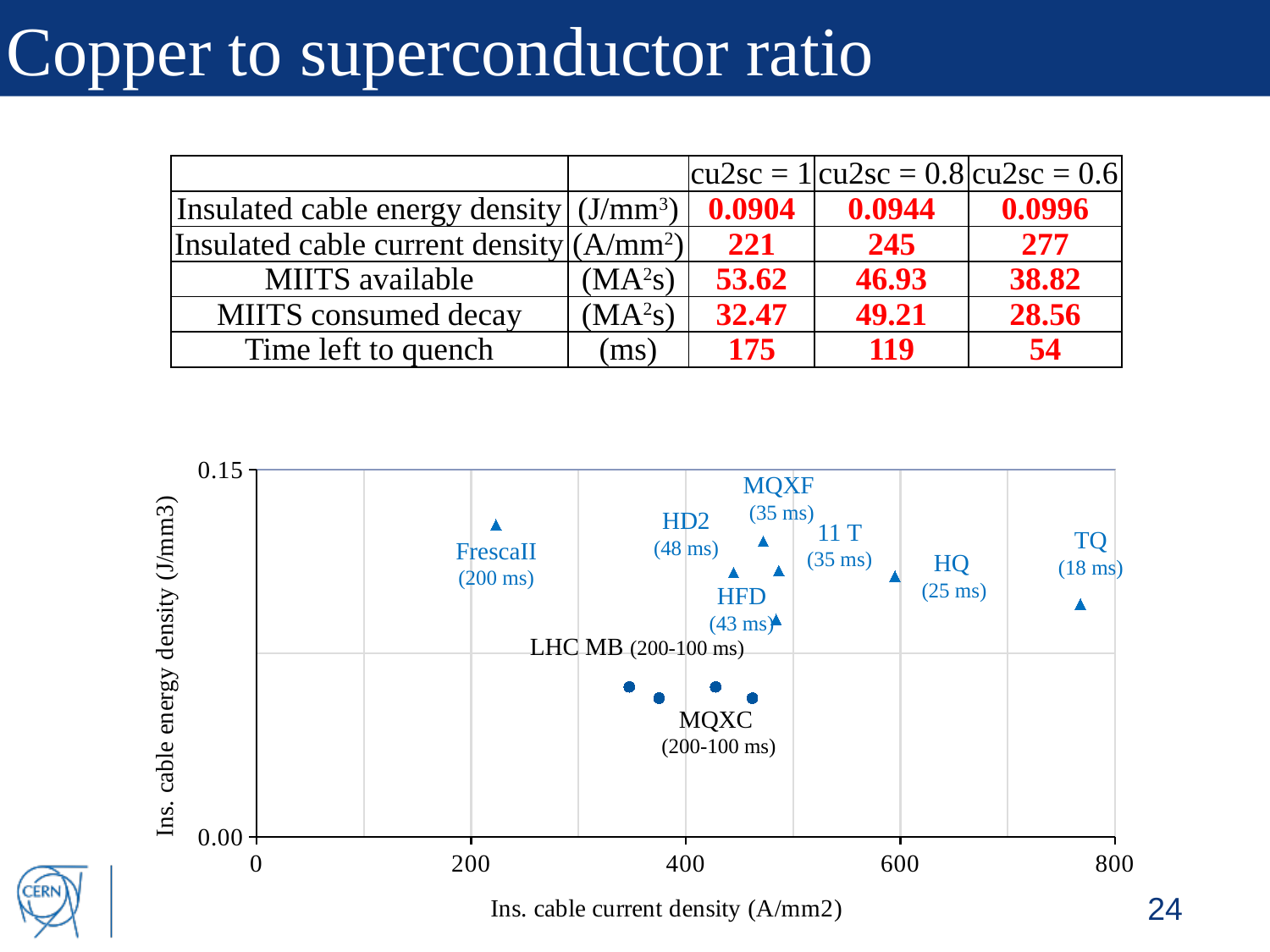
Which has a higher insulated cable current density, TQ or FrescaII? TQ What time to quench is annotated for FrescaII in the chart? 200 ms Which magnet has the highest insulated cable current density in the chart? TQ What is the label of the x axis of the chart? Ins. cable current density (A/mm2) What time to quench is annotated for TQ in the chart? 18 ms What is the label of the y axis of the chart? Ins. cable energy density (J/mm3) What kind of chart is shown on the slide? scatter chart Is the insulated cable current density for MQXF greater or less than 600? less Is the insulated cable current density for FrescaII greater or less than 400? less Which magnet has the lowest insulated cable current density in the chart? FrescaII Is the insulated cable current density for TQ greater or less than 600? greater Which magnet has the highest insulated cable energy density in the chart? FrescaII